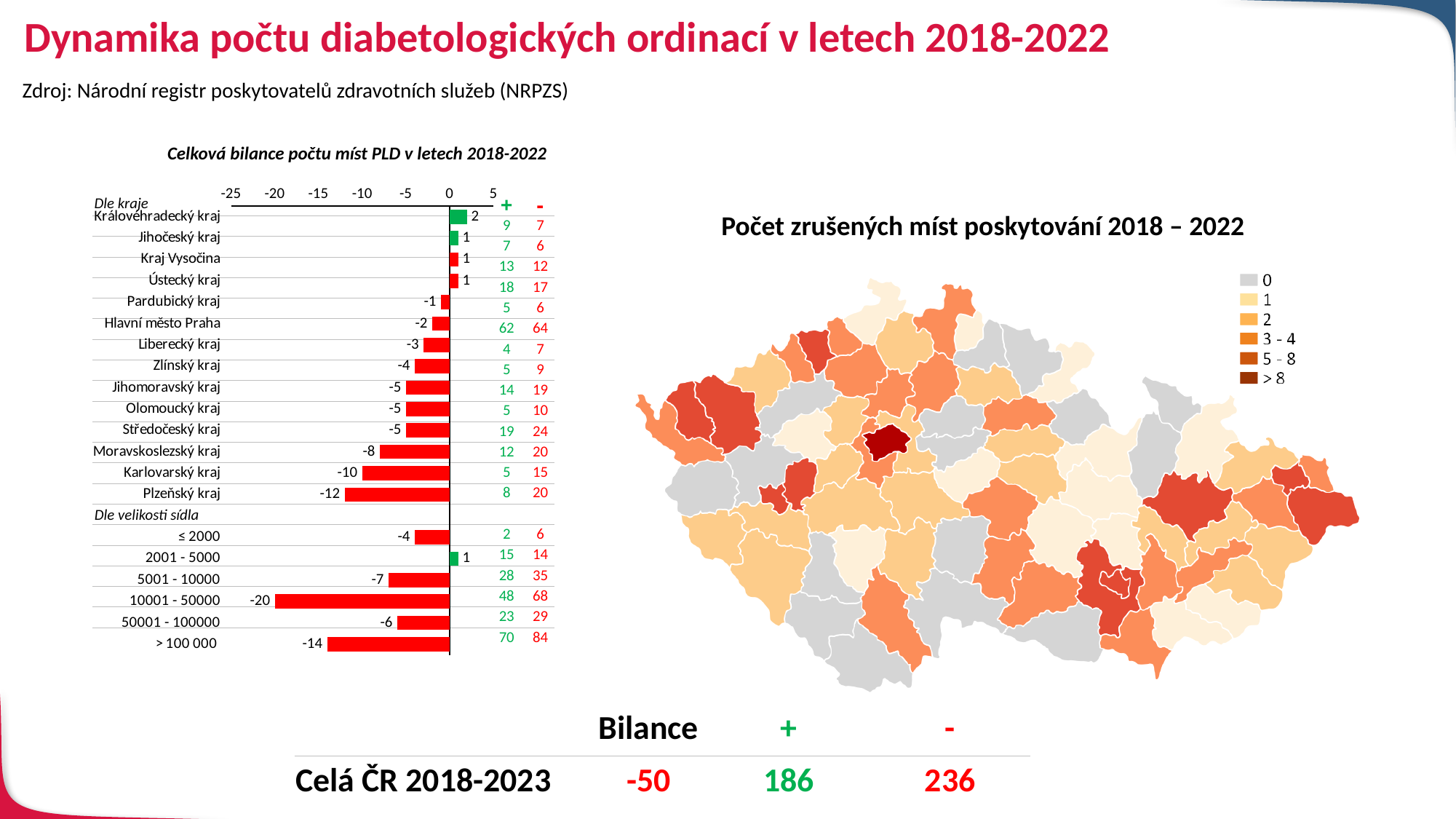
How many regions (Dle kraje) are listed in the chart 'Celková bilance počtu míst PLD v letech 2018-2022'? 14 In the chart 'Celková bilance počtu míst PLD v letech 2018-2022', which settlement-size category (Dle velikosti sídla) has the lowest value? 10001 - 50000 In the chart 'Celková bilance počtu míst PLD v letech 2018-2022', which has the larger value, Moravskoslezský kraj or Liberecký kraj? Liberecký kraj What kind of chart is 'Celková bilance počtu míst PLD v letech 2018-2022'? bar chart In the chart 'Celková bilance počtu míst PLD v letech 2018-2022', which region (Dle kraje) has the highest value? Královéhradecký kraj In the chart 'Celková bilance počtu míst PLD v letech 2018-2022', what is the value for the size category 10001 - 50000? -20 In the chart 'Celková bilance počtu míst PLD v letech 2018-2022', what is the difference between the values for Karlovarský kraj and Plzeňský kraj? 2 In the chart 'Celková bilance počtu míst PLD v letech 2018-2022', what is the value for Plzeňský kraj? -12 In the chart 'Celková bilance počtu míst PLD v letech 2018-2022', is the value for the category 10001 - 50000 greater or less than -15? less In the chart 'Celková bilance počtu míst PLD v letech 2018-2022', what is the value for Karlovarský kraj? -10 What is the title of the map on the right side of the slide? Počet zrušených míst poskytování 2018 – 2022 In the chart 'Celková bilance počtu míst PLD v letech 2018-2022', which region (Dle kraje) has the lowest value? Plzeňský kraj